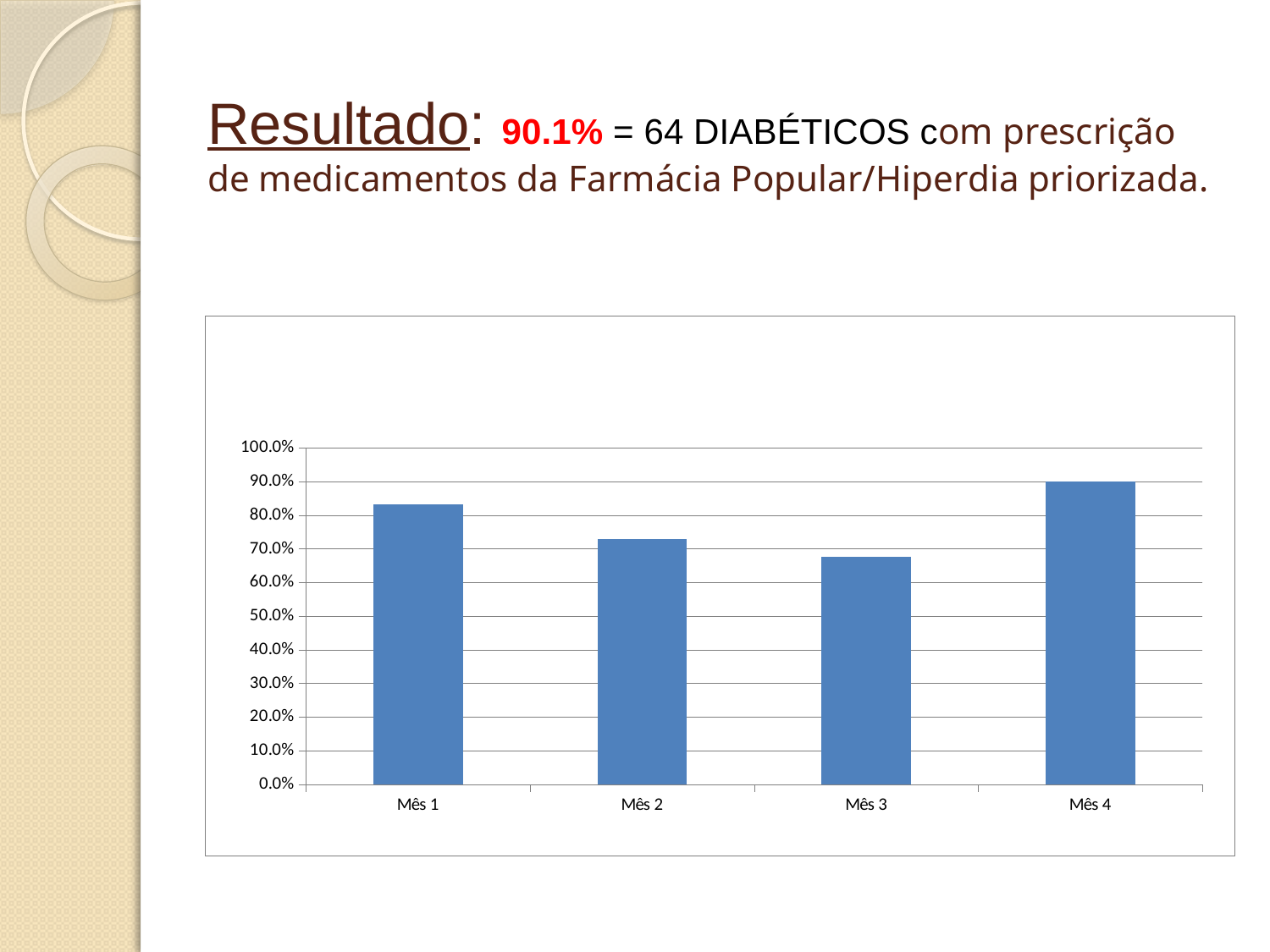
Is the value for Mês 2 greater or less than 80.0%? less What kind of chart is shown on the slide? bar chart What colour are the bars in the chart? blue Is the value for Mês 1 greater or less than 80.0%? greater Do the values fall or rise from Mês 1 to Mês 3? fall Which is larger, the value for Mês 3 or the value for Mês 4? Mês 4 Which is larger, the value for Mês 1 or the value for Mês 2? Mês 1 How many categories (months) are shown on the x axis of the chart? 4 Is the value for Mês 3 greater or less than 70.0%? less Which month has the highest bar in the chart? Mês 4 Which month has the lowest bar in the chart? Mês 3 What is the highest value shown on the y axis of the chart? 100.0%